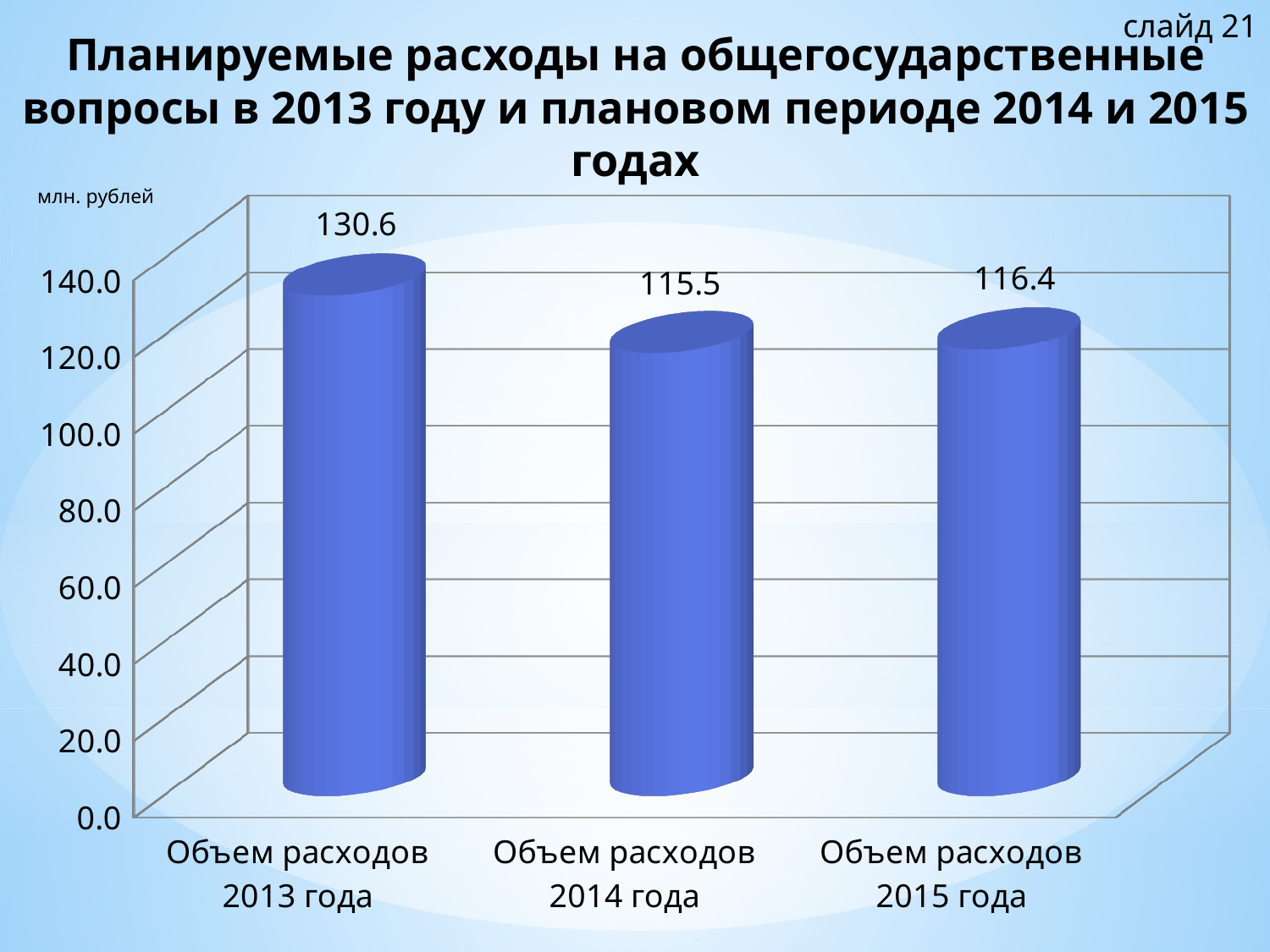
Which year has the lowest planned expenditure on the chart? 2014 Is the value for 2014 greater or less than 120.0? less What unit of measurement is indicated for the chart values? млн. рублей What is the value shown for Объем расходов 2015 года? 116.4 Which year has the highest planned expenditure on the chart? 2013 What is the planned expenditure value shown for 2013 (Объем расходов 2013 года)? 130.6 What kind of chart is shown on the slide? bar chart Which is larger, the value for 2013 or the value for 2015? 2013 What is the difference between the 2013 value and the 2014 value? 15.1 What is the difference between the 2015 value and the 2014 value? 0.9 What is the value shown for Объем расходов 2014 года? 115.5 How many bars are plotted on the chart? 3